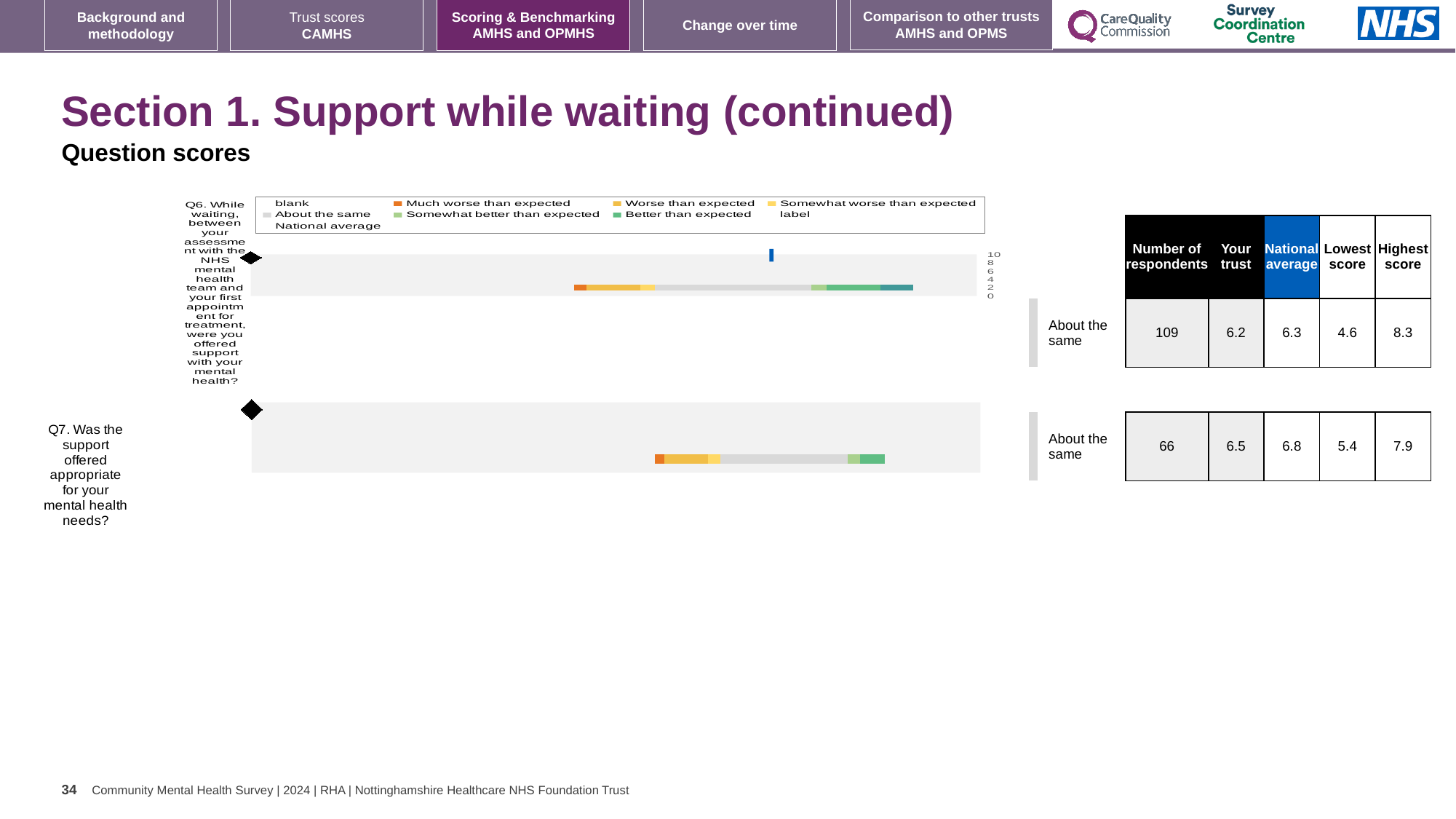
What is the national average for Q7? 6.8 What is the highest score recorded for Q6? 8.3 How many questions (bars) are plotted in the chart? 2 What is the difference between the national average and the trust's score for Q7? 0.3 How many respondents answered Q6? 109 What is the difference in the number of respondents between Q6 and Q7? 43 What is the trust's score for Q6 (support while waiting between assessment and first appointment)? 6.2 What is the trust's score for Q7 (Was the support offered appropriate for your mental health needs?)? 6.5 What does the blue marker in the legend represent? National average What kind of chart is shown on the slide? Bar chart Which question had more respondents, Q6 or Q7? Q6 Which legend entry is shown in orange? Much worse than expected